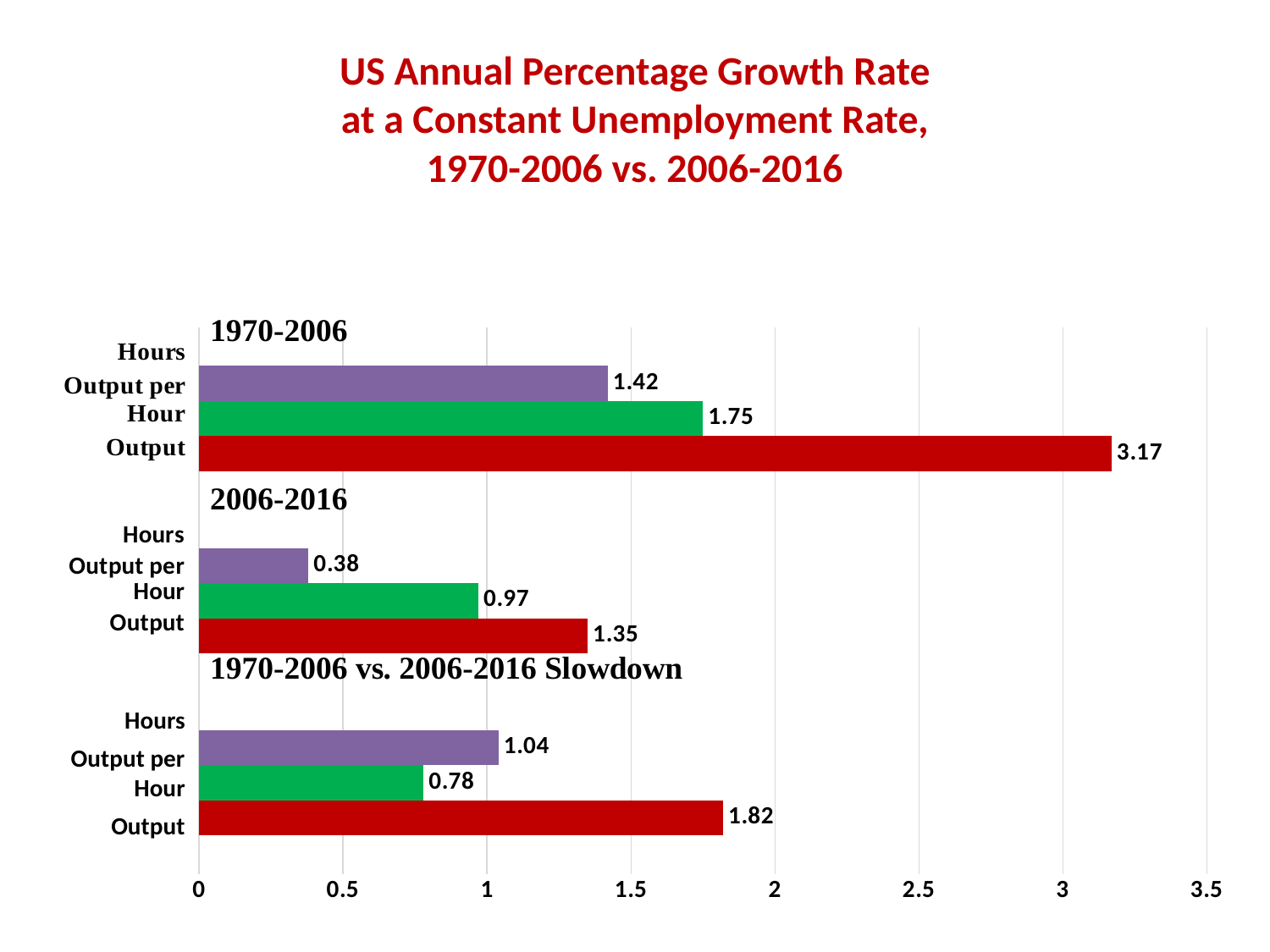
What is the value for Output per Hour in the 1970-2006 vs. 2006-2016 Slowdown group? 0.78 How many bars are plotted on the chart in total? 9 Which bar has the highest value on the chart? Output, 1970-2006 What is the difference between the Output values for 1970-2006 and 2006-2016? 1.82 What is the value for Hours in the 2006-2016 group? 0.38 Which bar has the lowest value on the chart? Hours, 2006-2016 What kind of chart is shown on the slide? bar chart What colour are the Output bars? red Is the value for Output in the Slowdown group greater or less than 2? less What is the value for Output in the 1970-2006 group? 3.17 What is the value for Output per Hour in the 2006-2016 group? 0.97 Which is larger: Hours in 1970-2006 or Output in 2006-2016? Hours in 1970-2006